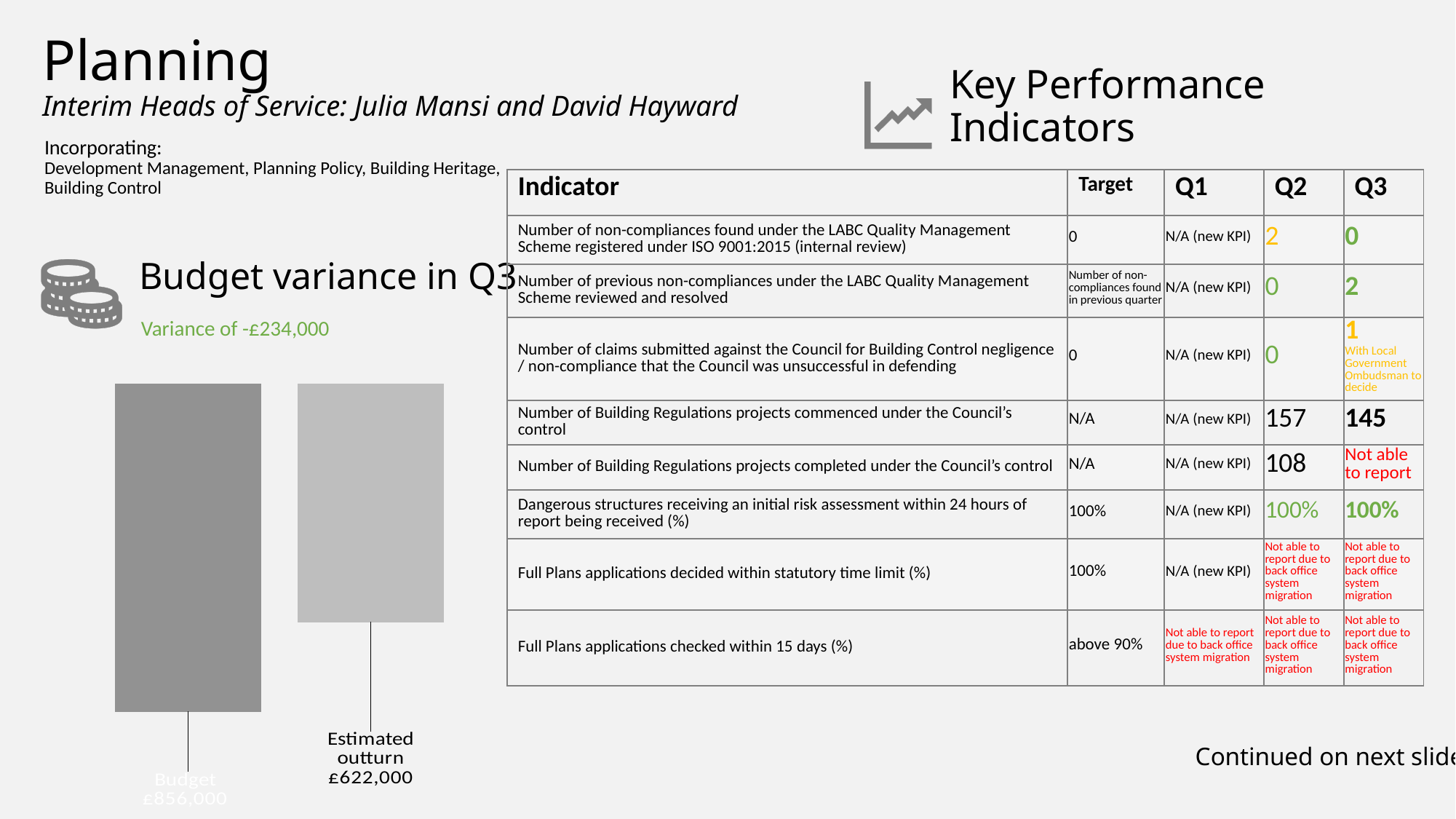
In the bar chart under 'Budget variance in Q3', which bar is the tallest? Budget In the bar chart under 'Budget variance in Q3', which bar is the shortest? Estimated outturn In the bar chart under 'Budget variance in Q3', what is the difference between the Budget and the Estimated outturn? £234,000 What variance is stated in the text beneath the 'Budget variance in Q3' heading? Variance of -£234,000 In the bar chart under 'Budget variance in Q3', what is the value of the Estimated outturn bar? £622,000 What is the heading above the bar chart on the left of the slide? Budget variance in Q3 In the bar chart under 'Budget variance in Q3', what is the value of the Budget bar? £856,000 What kind of chart is shown under the heading 'Budget variance in Q3'? Bar chart In the bar chart under 'Budget variance in Q3', which is larger, the Budget or the Estimated outturn? Budget In the bar chart under 'Budget variance in Q3', do the values rise or fall from the Budget bar to the Estimated outturn bar? Fall How many bars are shown in the bar chart under 'Budget variance in Q3'? 2